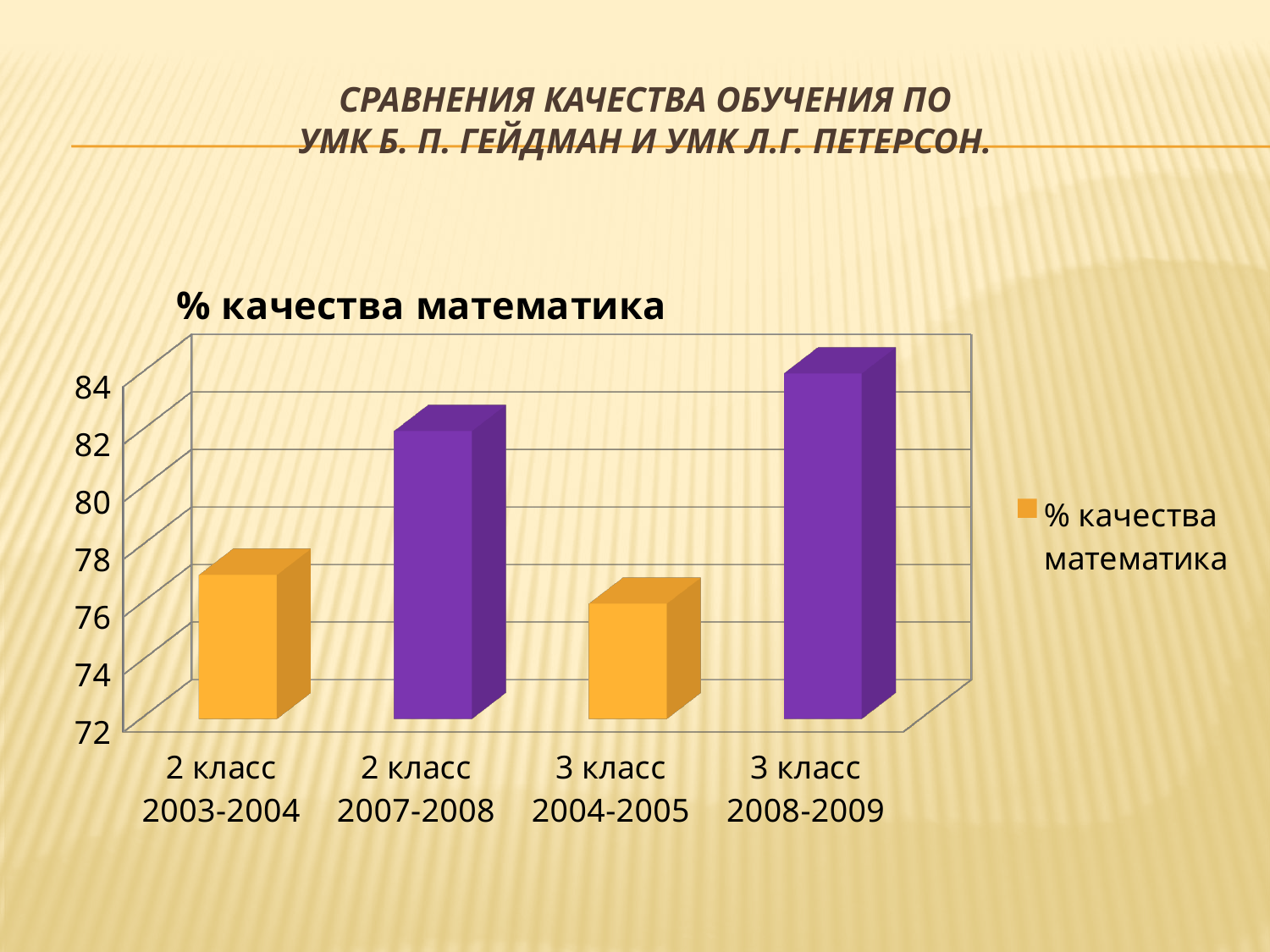
Which category has the highest value in the chart? 3 класс 2008-2009 Is the value for 3 класс 2004-2005 greater or less than 78? less Is the value for 2 класс 2003-2004 greater or less than 76? greater Is the value for 3 класс 2008-2009 greater or less than 82? greater Which category has the lowest value in the chart? 3 класс 2004-2005 How many categories are shown on the x axis of the chart? 4 What is the title of the chart? % качества математика Which is larger, the value for 2 класс 2007-2008 or the value for 3 класс 2004-2005? 2 класс 2007-2008 What kind of chart is shown on the slide? bar chart How many series does the chart legend list? 1